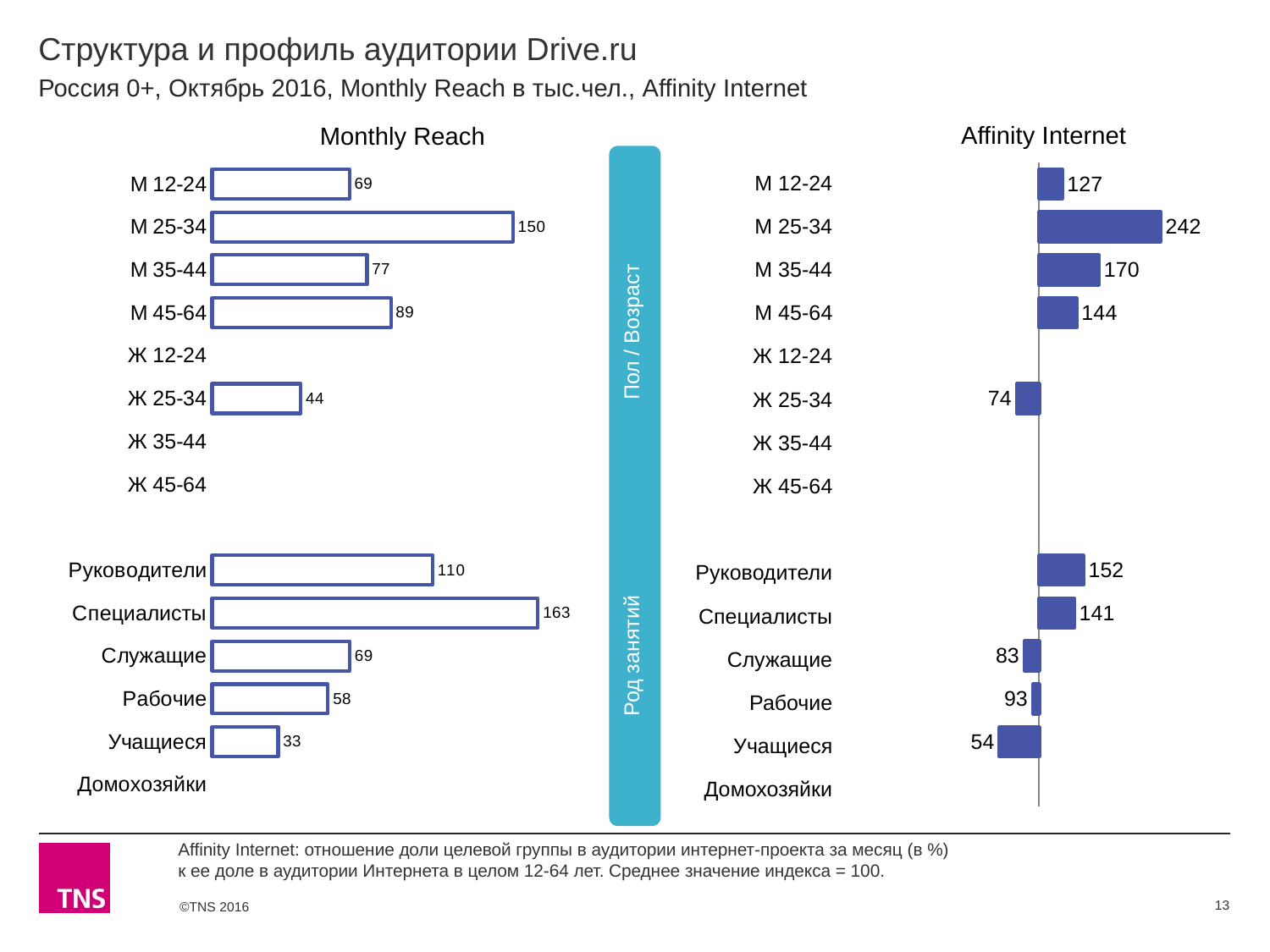
In the Monthly Reach chart, which category has the highest value? Специалисты In the Monthly Reach chart, which is larger: Руководители or М 45-64? Руководители In the Monthly Reach chart, what is the value for Учащиеся? 33 In the Affinity Internet chart, what is the difference between Руководители and Служащие? 69 In the Monthly Reach chart, how many categories are listed under Род занятий? 6 In the Affinity Internet chart, which category has the highest value? М 25-34 In the Monthly Reach chart, what is the value for М 25-34? 150 In the Affinity Internet chart, which category with a plotted bar has the lowest value? Учащиеся In the Affinity Internet chart, what is the value for Специалисты? 141 In the Monthly Reach chart, what is the difference between М 25-34 and М 12-24? 81 In the Affinity Internet chart, what is the value for Ж 25-34? 74 What kind of chart is the Affinity Internet chart? Bar chart